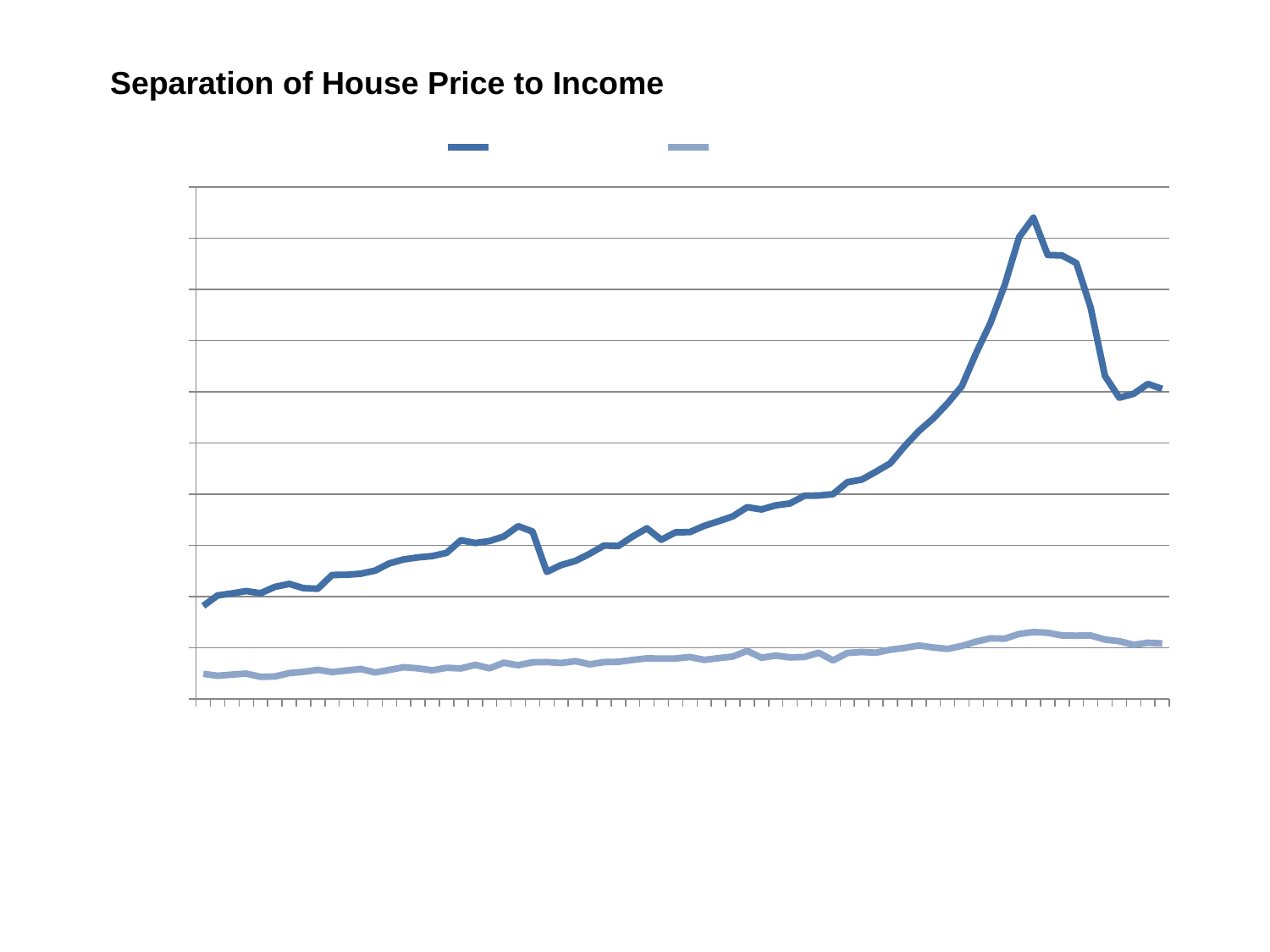
Do the values of the dark blue line generally rise or fall from the left end of the x axis to the right end? rise What is the title of the slide? Separation of House Price to Income Does the dark blue line rise or fall after reaching its peak near the right side of the chart? fall Are the two lines plotted in the same colour or different colours? different colours What kind of chart is shown on the slide? line chart How many series does the legend show? 2 Do the values of the light blue line generally rise or fall from the left end of the x axis to the right end? rise Which line is higher across the chart, the dark blue line or the light blue line? the dark blue line